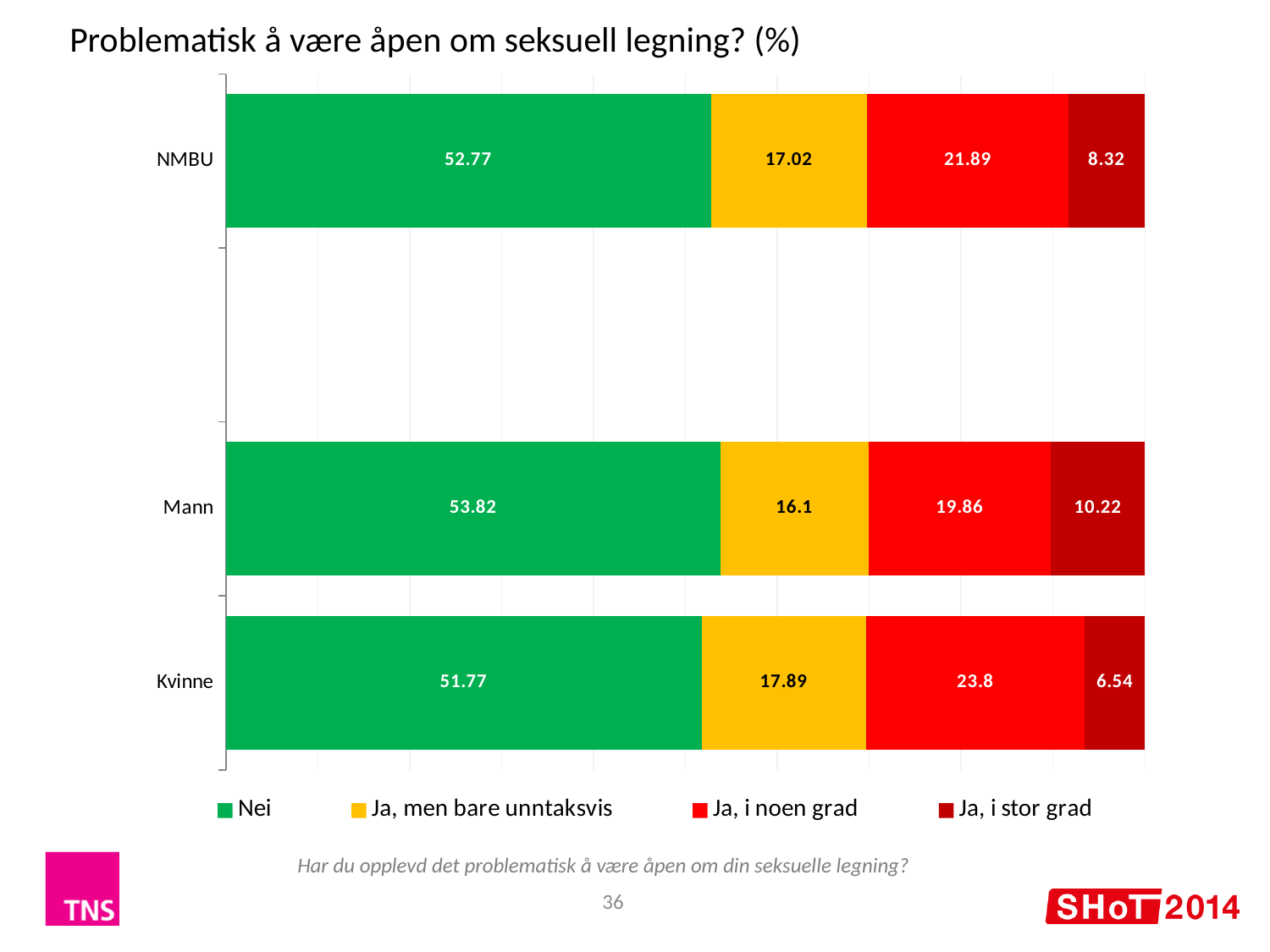
What is the value for "Nei" for NMBU? 52.77 What is the difference between the "Ja, i stor grad" values for Mann and Kvinne? 3.68 What is the value for "Ja, men bare unntaksvis" for Mann? 16.1 How many series does the legend list? 4 How many categories are shown on the y axis? 3 What is the value for "Ja, i noen grad" for Kvinne? 23.8 What is the value for "Ja, i stor grad" for Mann? 10.22 What is the difference between the "Nei" values for Mann and Kvinne? 2.05 Which category has the lowest value for "Ja, i stor grad"? Kvinne What kind of chart is shown on the slide? Stacked bar chart Which is larger: the "Ja, i noen grad" value for Kvinne or for Mann? Kvinne Which category has the highest value for "Nei"? Mann